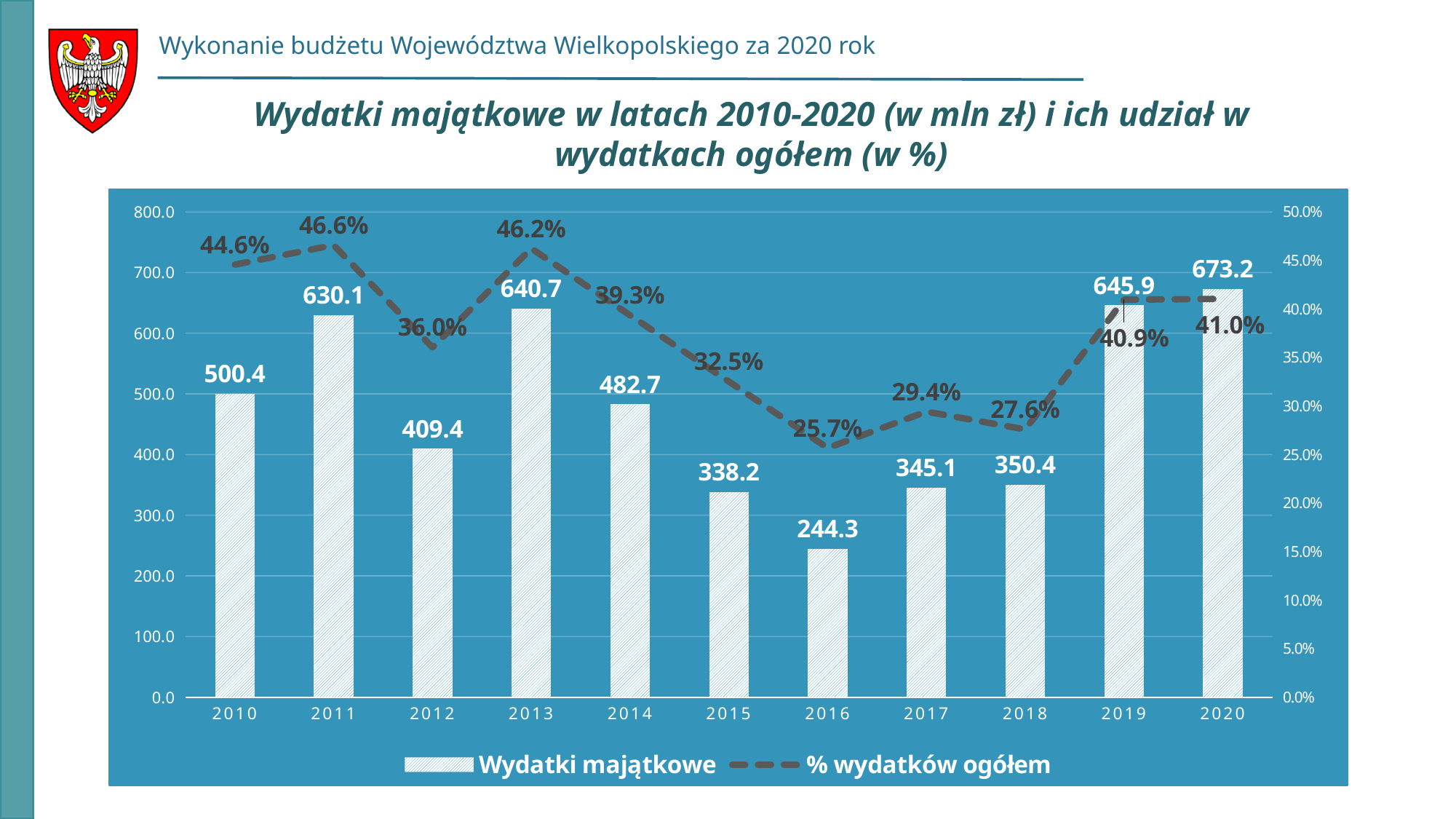
Is the Wydatki majątkowe value for 2014 greater or less than 500.0? less How many years are shown on the x axis? 11 Which is larger, Wydatki majątkowe in 2011 or in 2013? 2013 How many series does the legend list? 2 What is the difference between Wydatki majątkowe in 2020 and 2019? 27.3 Does the % wydatków ogółem value rise or fall from 2013 to 2016? fall What is the value of Wydatki majątkowe for 2013? 640.7 What is the % wydatków ogółem value for 2016? 25.7% What kind of chart is used for the Wydatki majątkowe series? bar chart What is the % wydatków ogółem value for 2011? 46.6% Which year has the lowest % wydatków ogółem? 2016 Which year has the highest Wydatki majątkowe? 2020